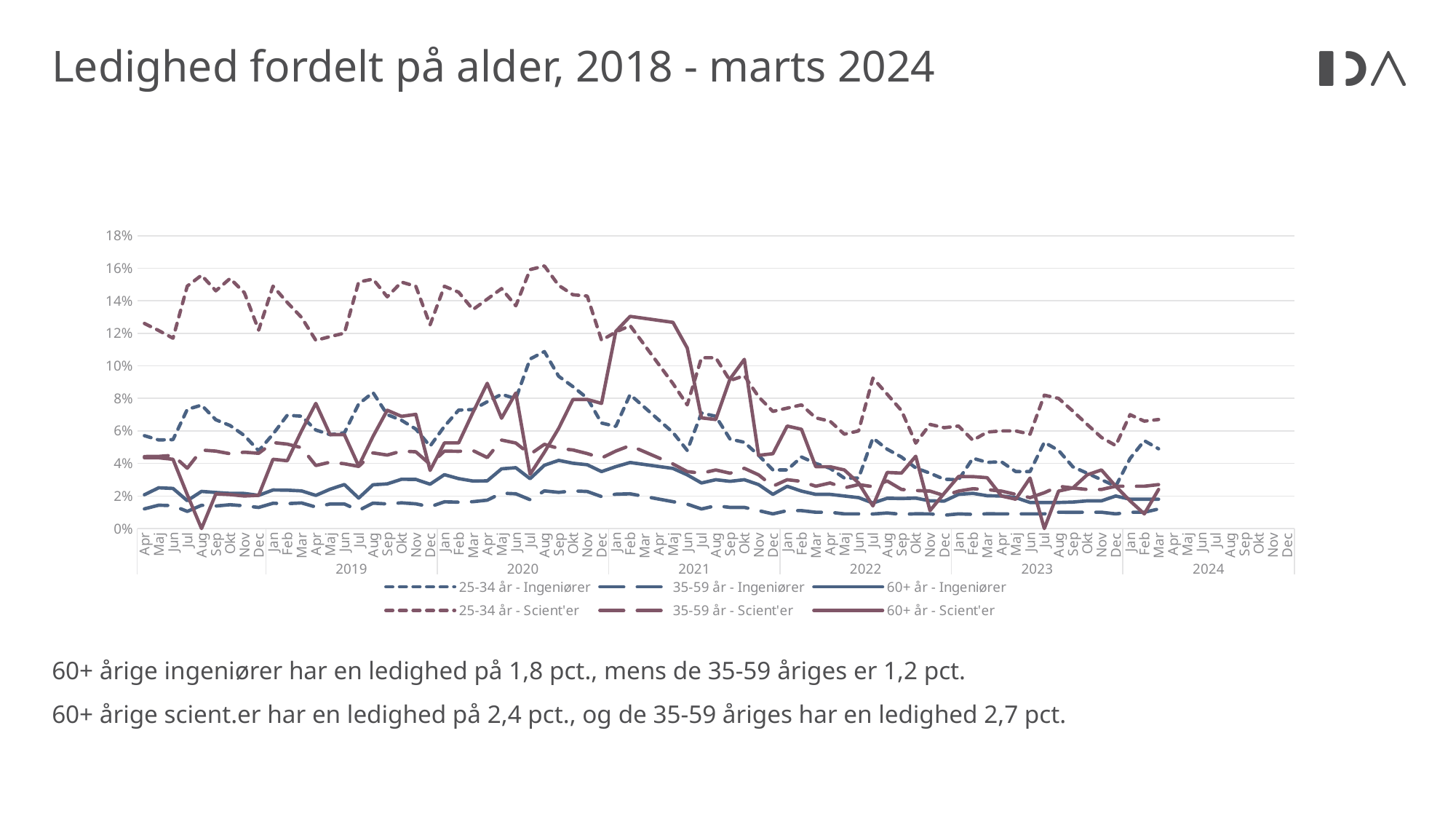
Is the value for 60+ år - Scient'er in Feb 2021 greater or less than 10%? greater What is the title of the chart slide? Ledighed fordelt på alder, 2018 - marts 2024 Does the 25-34 år - Scient'er series rise or fall overall from 2018 to 2024? Fall What kind of chart is shown on the slide? Line chart Is the value for 35-59 år - Ingeniører in Jul 2023 greater or less than 2%? less Which series has the highest unemployment values across most of the period? 25-34 år - Scient'er In 2019, which is larger: 25-34 år - Scient'er or 25-34 år - Ingeniører? 25-34 år - Scient'er According to the slide text, what is the unemployment rate for 60+ årige ingeniører? 1,8 pct. According to the slide text, what is the unemployment rate for 35-59 årige scient.er? 2,7 pct. How many series does the legend list? 6 Is the value for 25-34 år - Scient'er in Aug 2020 greater or less than 14%? greater Which series has the lowest unemployment values across most of the period? 35-59 år - Ingeniører